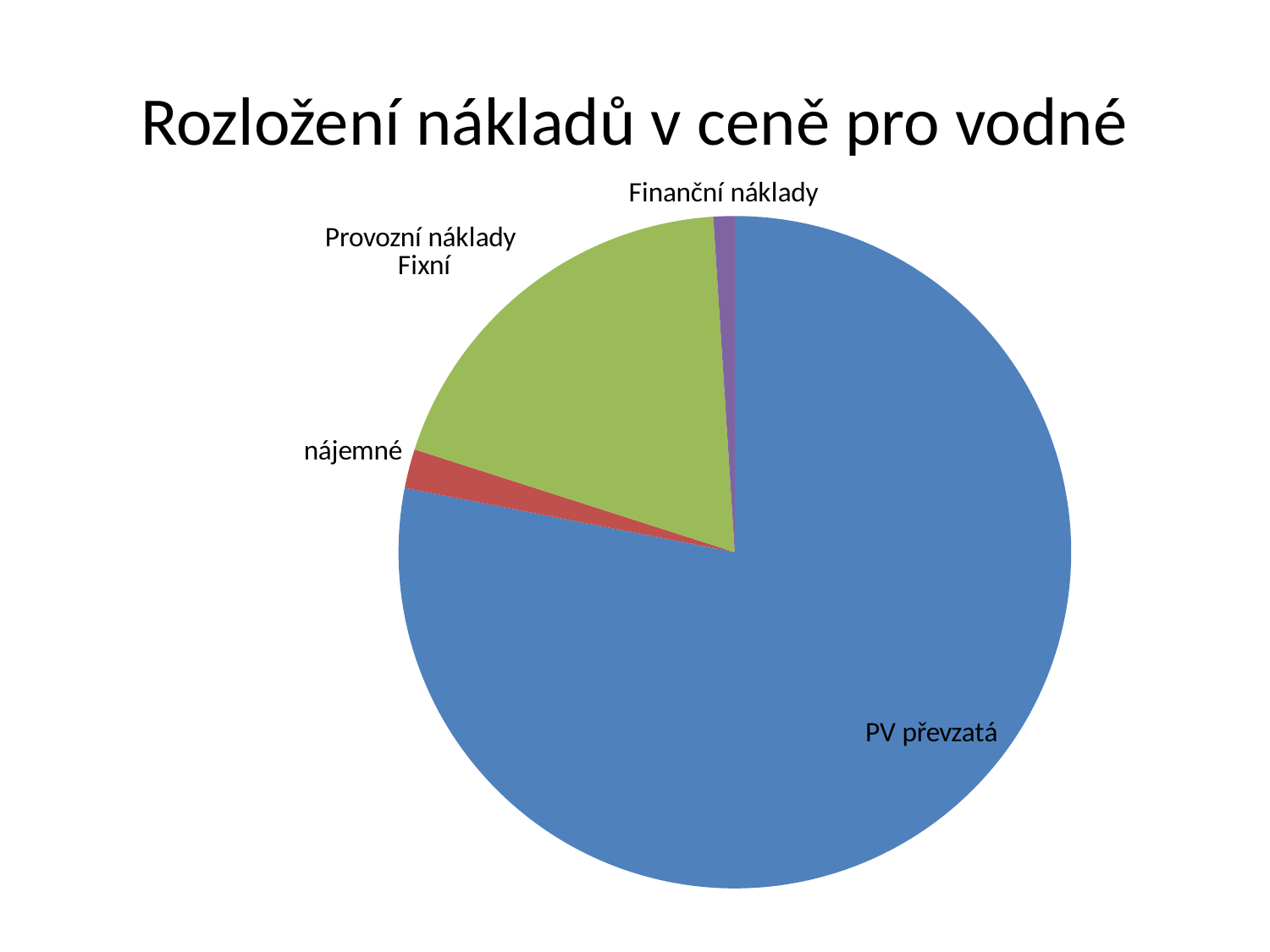
Which slice is larger, PV převzatá or Provozní náklady Fixní? PV převzatá Which category has the smallest slice of the pie? Finanční náklady What is the title of the slide? Rozložení nákladů v ceně pro vodné Which category has the largest slice of the pie? PV převzatá Which category has the second-largest slice of the pie? Provozní náklady Fixní How many slices does the pie chart have? 4 What colour is the slice for Provozní náklady Fixní? Green Does PV převzatá account for more or less than half of the pie? more Which slice is larger, Provozní náklady Fixní or nájemné? Provozní náklady Fixní What kind of chart is shown on the slide? Pie chart Which slice is larger, nájemné or Finanční náklady? nájemné